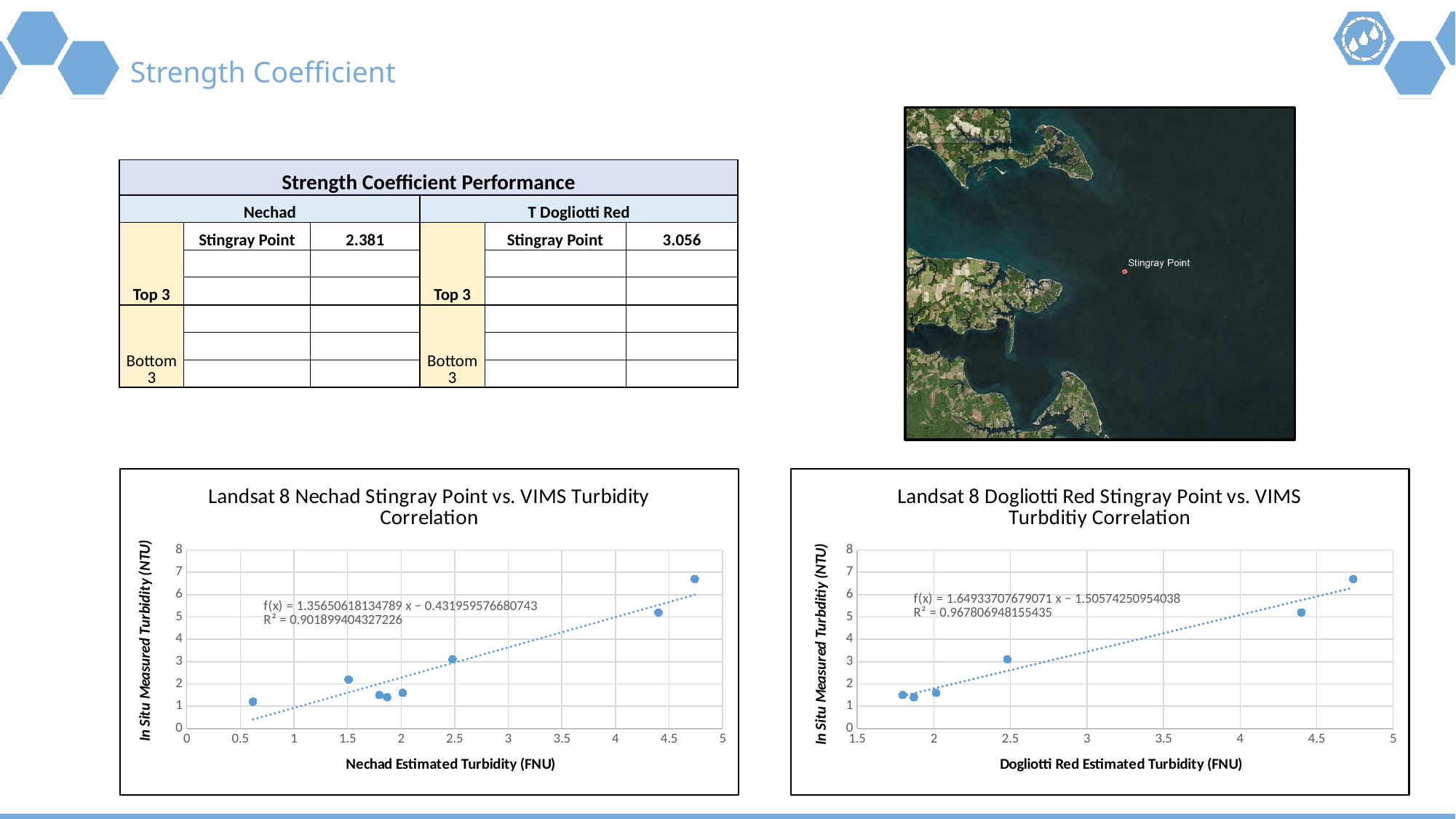
What kind of chart is the left chart titled 'Landsat 8 Nechad Stingray Point vs. VIMS Turbidity Correlation'? Scatter chart In the right chart (Dogliotti Red), what is the R² value printed on the chart? 0.967806948155435 In the left chart (Nechad), what is the trendline equation printed on the chart? f(x) = 1.35650618134789 x − 0.431959576680743 In the left chart (Nechad), is the estimated turbidity of the rightmost point greater or less than 4.5 FNU? greater In the left chart (Nechad), do the in situ turbidity values generally rise or fall as the estimated turbidity increases along the x axis? Rise In the right chart (Dogliotti Red), is the in situ turbidity of the highest point greater or less than 6 NTU? greater Which chart shows the higher R² value, the left Nechad chart or the right Dogliotti Red chart? The right Dogliotti Red chart In the right chart (Dogliotti Red), what is the trendline equation printed on the chart? f(x) = 1.64933707679071 x − 1.50574250954038 What kind of chart is the right chart titled 'Landsat 8 Dogliotti Red Stingray Point vs. VIMS Turbditiy Correlation'? Scatter chart What is the y-axis label of the right chart (Dogliotti Red)? In Situ Measured Turbditiy (NTU) In the left chart (Nechad), what is the R² value printed on the chart? 0.901899404327226 What is the x-axis label of the left chart (Nechad)? Nechad Estimated Turbidity (FNU)